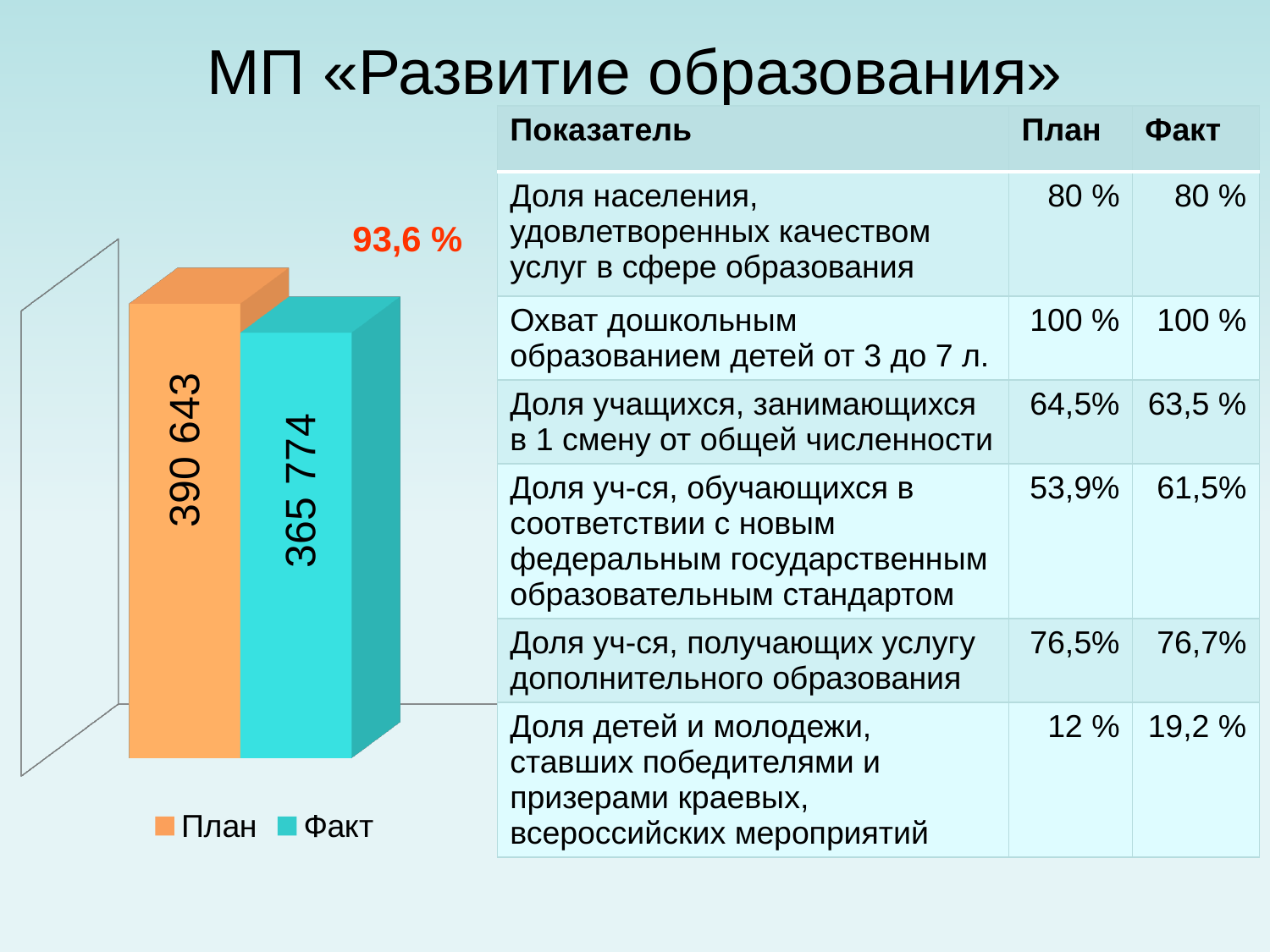
Which series has the lowest value in the chart? Факт How many series does the chart legend list? 2 Which series has the highest value in the chart? План What is the value of the План bar in the chart? 390 643 What is the difference between the План and Факт values in the chart? 24 869 What is the value of the Факт bar in the chart? 365 774 What colour is the Факт bar in the chart? turquoise How many bars are plotted in the chart? 2 Which bar in the chart is higher, План or Факт? План What kind of chart is shown on the slide? bar chart What percentage is printed above the bars in the chart? 93,6 %